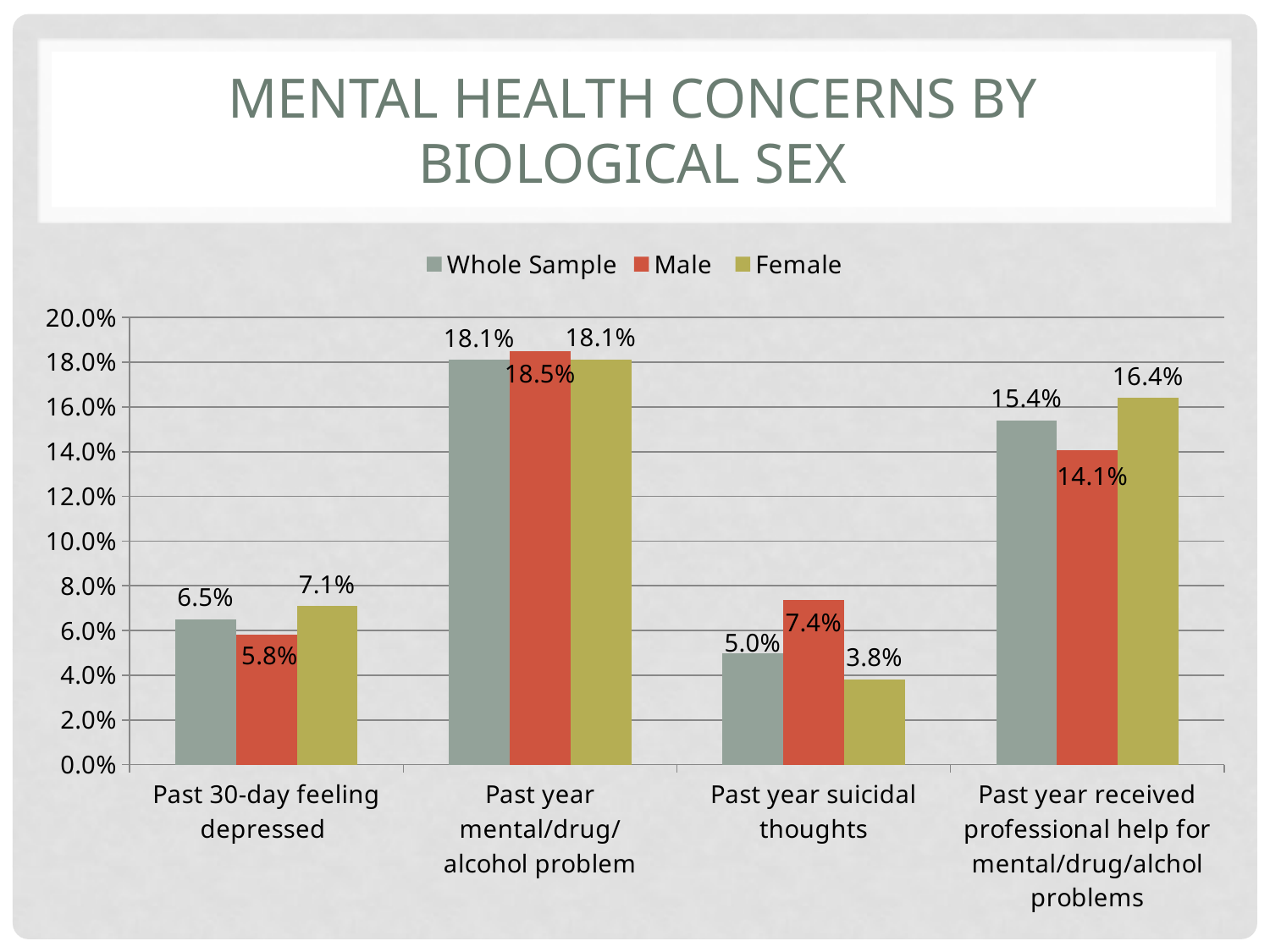
How many series does the legend list? 3 Which category has the lowest Male value? Past 30-day feeling depressed Which category has the highest Female value? Past year mental/drug/alcohol problem What is the Male value for Past year suicidal thoughts? 7.4% How many categories are shown on the x axis? 4 What kind of chart is shown on the slide? Bar chart What is the Whole Sample value for Past 30-day feeling depressed? 6.5% Which is larger for Past year received professional help for mental/drug/alchol problems, the Male value or the Female value? Female What is the Male value for Past year mental/drug/alcohol problem? 18.5% What is the Female value for Past year received professional help for mental/drug/alchol problems? 16.4% Is the Whole Sample value for Past year received professional help for mental/drug/alchol problems greater or less than 14.0%? greater What is the difference between the Male and Female values for Past year suicidal thoughts? 3.6%